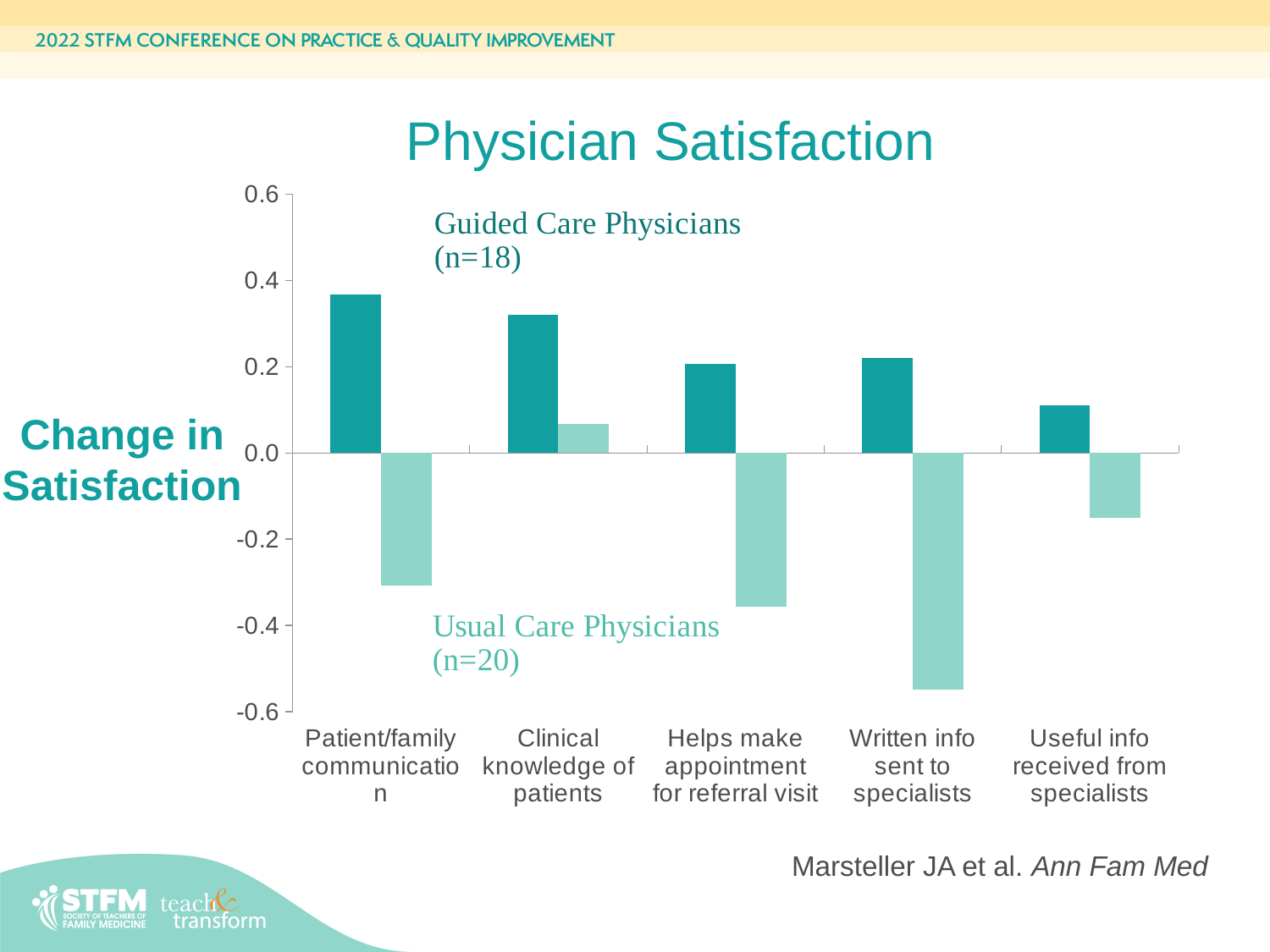
How many categories are shown along the x axis of the chart? 5 Which category has the lowest value for Guided Care Physicians? Useful info received from specialists Which category has the highest value for Usual Care Physicians? Clinical knowledge of patients Which category has the lowest value for Usual Care Physicians? Written info sent to specialists How many series does the chart show? 2 Is the value for Guided Care Physicians on Patient/family communication greater or less than 0.2? greater How many Guided Care Physicians are indicated in the chart's series label? 18 For Clinical knowledge of patients, which series has the larger value, Guided Care Physicians or Usual Care Physicians? Guided Care Physicians Is the value for Usual Care Physicians on Written info sent to specialists greater or less than -0.4? less What is the title of the chart? Physician Satisfaction Which category has the highest value for Guided Care Physicians? Patient/family communication What kind of chart is shown on the slide? bar chart